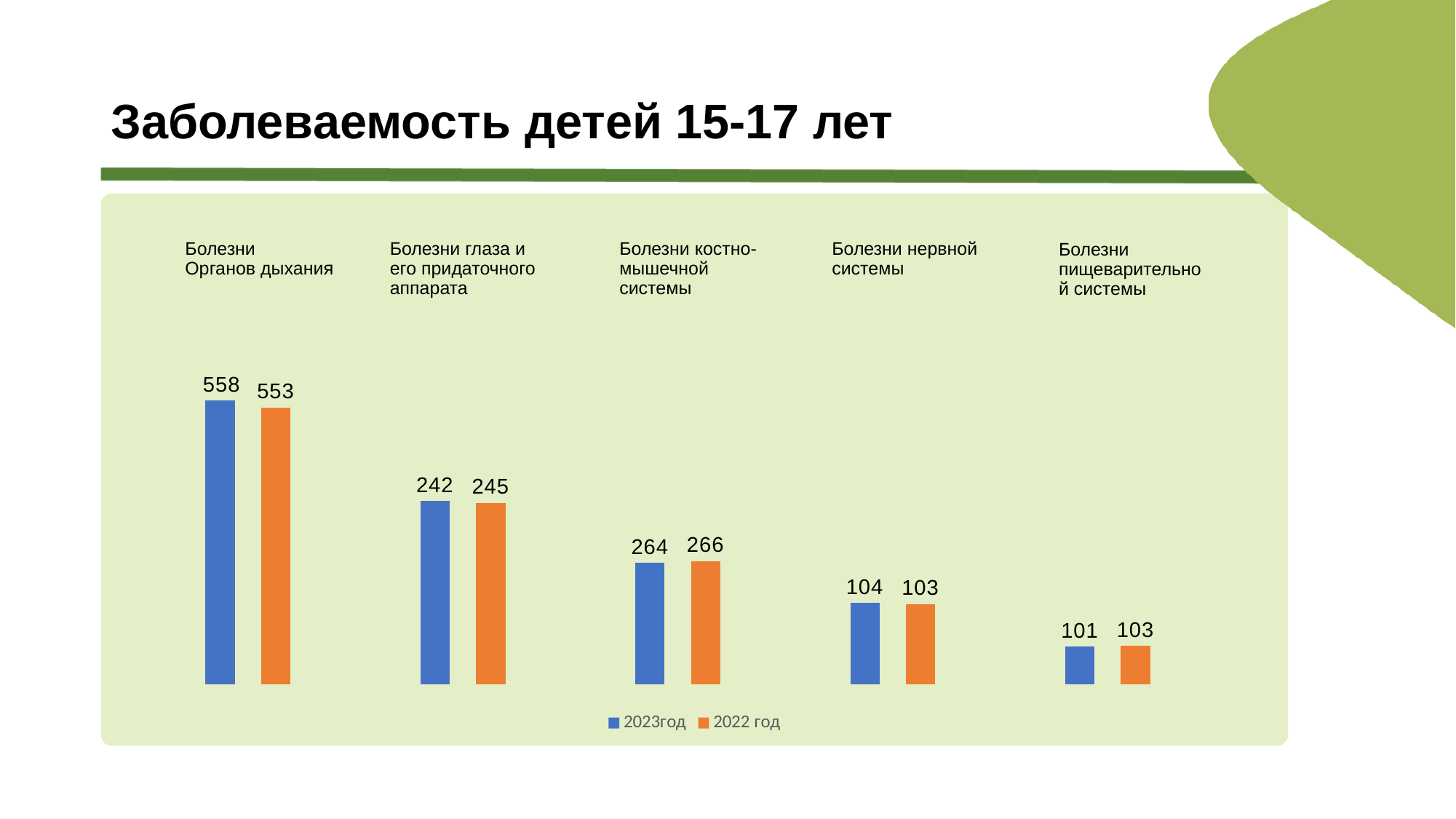
How many series does the legend list? 2 Which is larger for Болезни костно-мышечной системы: the 2023 value or the 2022 value? 2022 value What type of chart is shown on the slide? Bar chart How many disease categories are shown in the chart? 5 What is the difference between the 2023 values for Болезни костно-мышечной системы and Болезни нервной системы? 160 What is the 2022 value for Болезни глаза и его придаточного аппарата? 245 Which category has the highest 2023 value? Болезни органов дыхания Which category has the lowest 2023 value? Болезни пищеварительной системы What is the difference between the 2023 and 2022 values for Болезни органов дыхания? 5 What is the 2023 value for Болезни костно-мышечной системы? 264 What is the 2022 value for Болезни пищеварительной системы? 103 What is the 2023 value for Болезни органов дыхания? 558